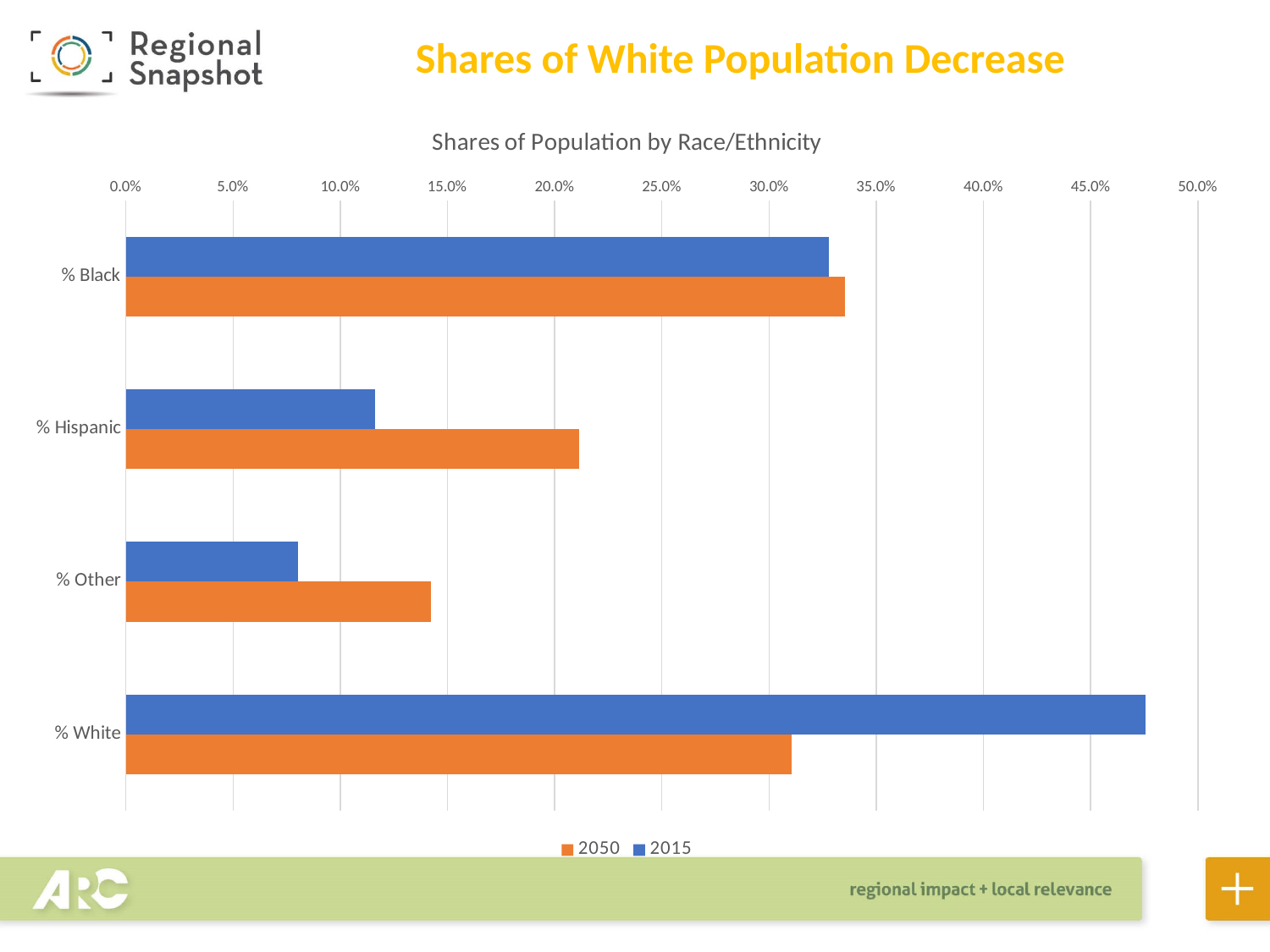
Is the 2050 value for % Hispanic greater or less than 20.0%? greater Which category has the highest value for 2015? % White Is the 2050 value for % White greater or less than 35.0%? less How many race/ethnicity categories are plotted? 4 Which category has the lowest value for 2050? % Other What is the title of the chart? Shares of Population by Race/Ethnicity Which category has the lowest value for 2015? % Other For % White, which is larger, the 2015 value or the 2050 value? 2015 Is the 2015 value for % White greater or less than 45.0%? greater How many series does the legend list? 2 What kind of chart is shown on the slide? bar chart